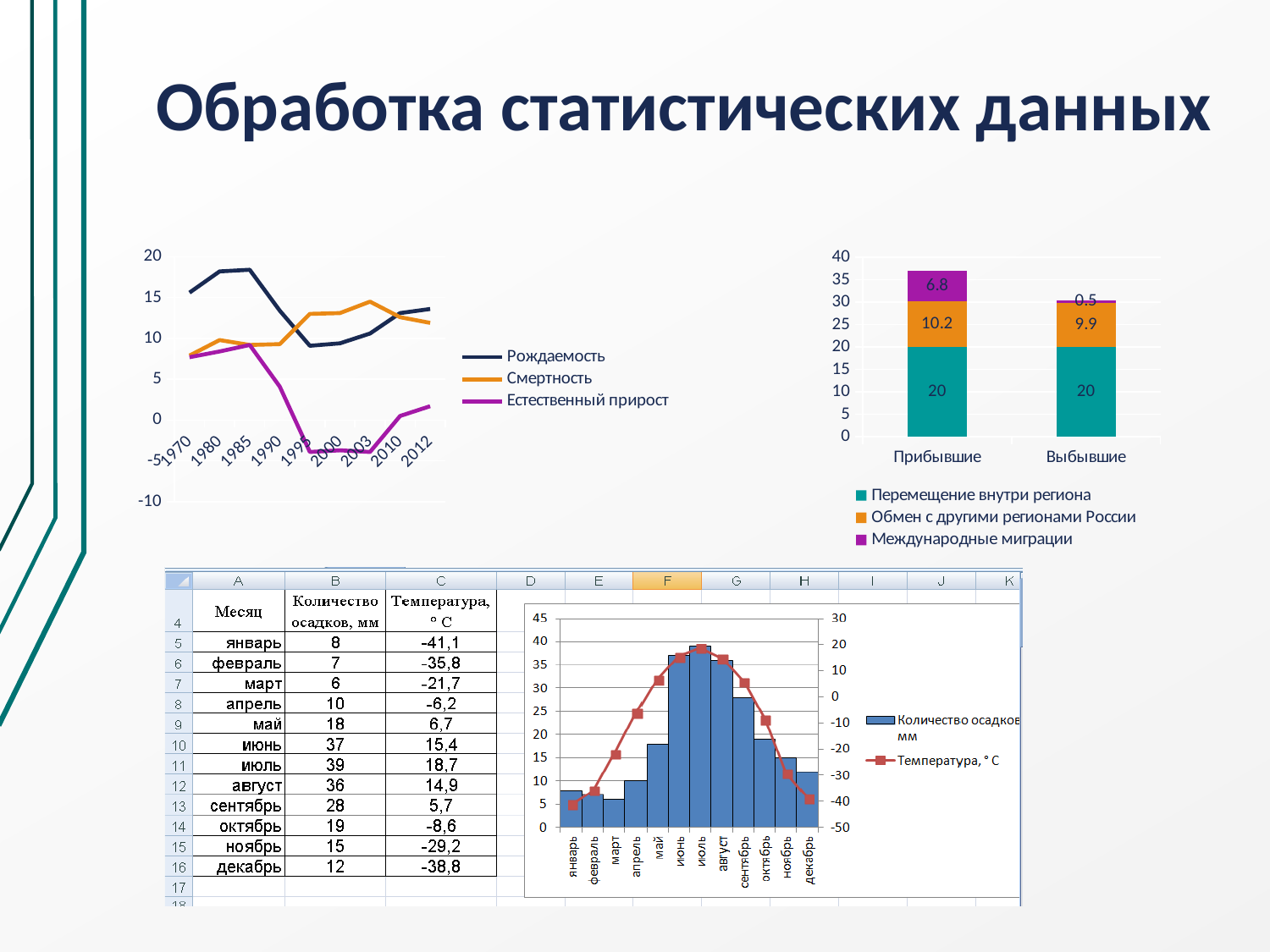
In the top-left line chart, is the value of Естественный прирост in 2000 greater or less than 0? less In the bottom chart, which month has the lowest Количество осадков, мм? март How many series does the legend of the top-right stacked bar chart list? 3 In the top-right stacked bar chart, what is the difference between the Международные миграции values for Прибывшие and Выбывшие? 6.3 In the top-right stacked bar chart, what is the value of Обмен с другими регионами России for Выбывшие? 9.9 In the top-right stacked bar chart, what is the total of the Выбывшие bar? 30.4 What kind of chart is the top-left chart? line chart In the top-right stacked bar chart, what is the total of the Прибывшие bar? 37 In the bottom chart, which month has the highest Количество осадков, мм? июль In the bottom chart, what is the Температура, °C for январь? -41,1 In the top-right stacked bar chart, what is the value of Международные миграции for Прибывшие? 6.8 In the top-left line chart, is the value of Рождаемость in 1985 greater or less than 15? greater